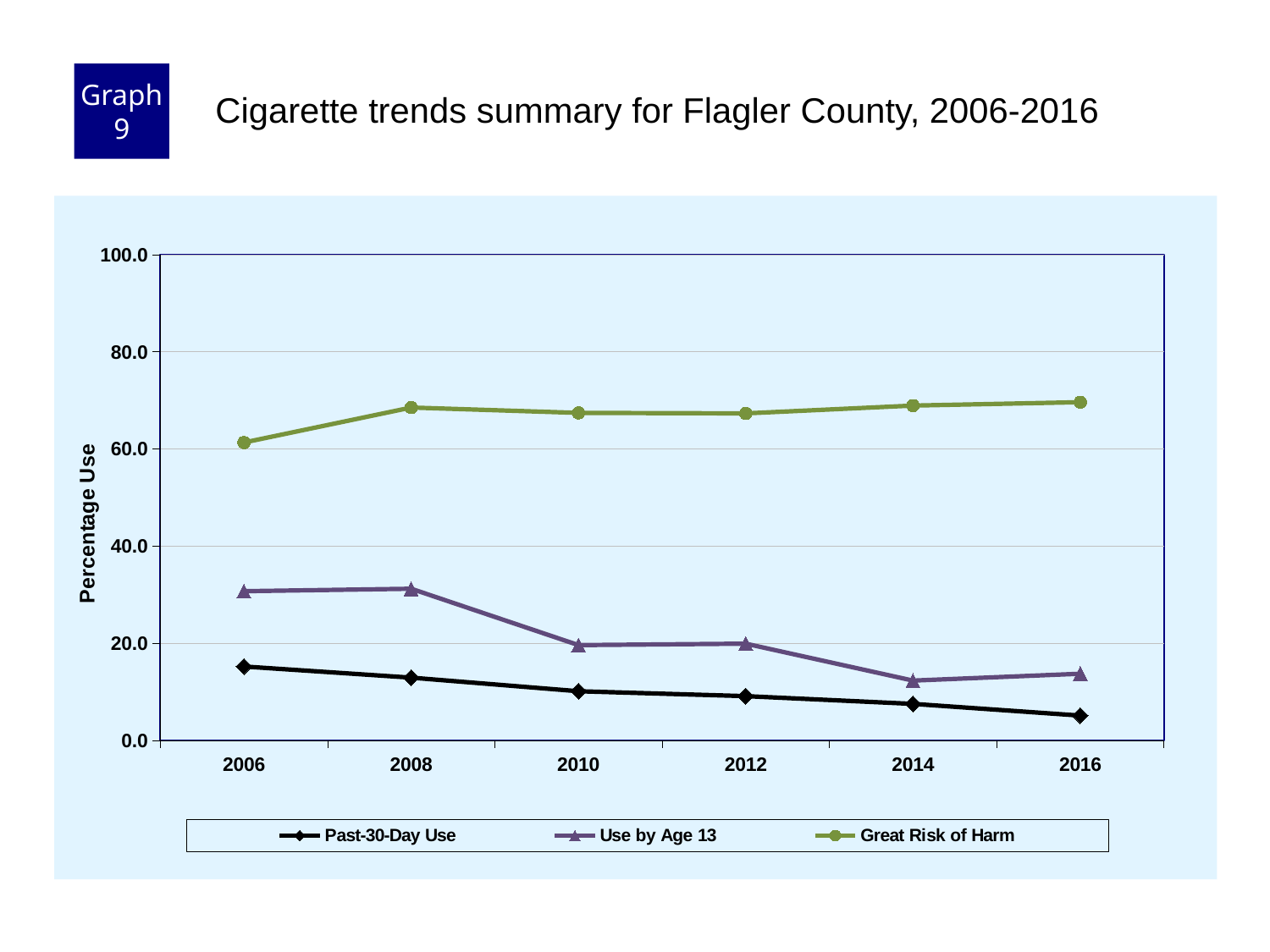
Which series is plotted highest on the chart across all years? Great Risk of Harm In which year is Past-30-Day Use at its lowest? 2016 In which year is Past-30-Day Use at its highest? 2006 Is the value for Great Risk of Harm in 2008 greater or less than 80.0? less How many years are plotted along the x axis? 6 In which year is Great Risk of Harm at its lowest? 2006 How many series does the legend list? 3 Is the value for Use by Age 13 in 2014 greater or less than 20.0? less What kind of chart is shown on the slide? line chart What is the title of the chart? Cigarette trends summary for Flagler County, 2006-2016 Does Past-30-Day Use rise or fall from 2006 to 2016? fall Is the value for Use by Age 13 in 2006 greater or less than 20.0? greater